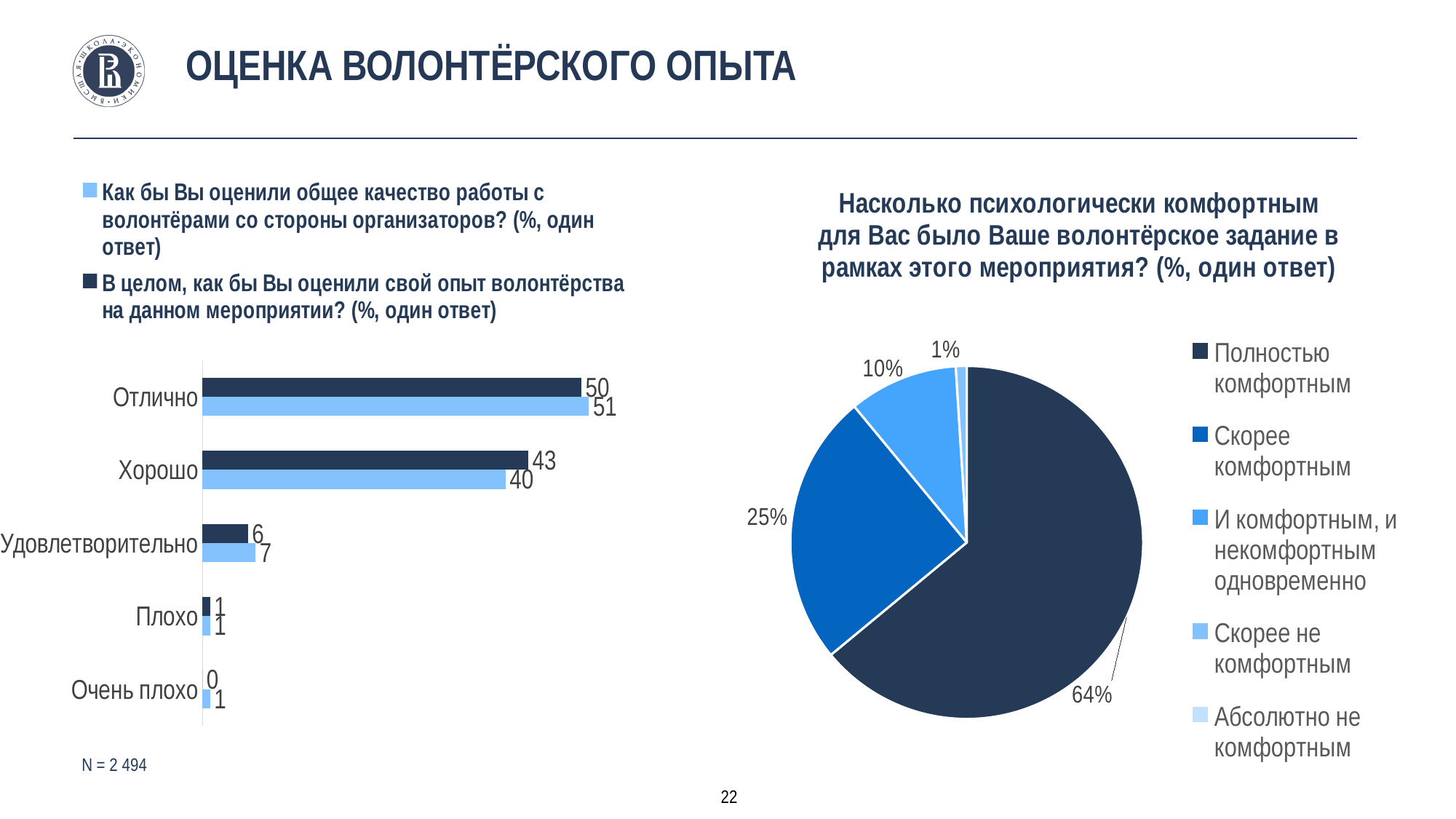
On the left bar chart, what is the value for Отлично in the series 'В целом, как бы Вы оценили свой опыт волонтёрства на данном мероприятии?'? 50 On the left bar chart, which category has the highest value in the series 'В целом, как бы Вы оценили свой опыт волонтёрства на данном мероприятии?'? Отлично On the pie chart 'Насколько психологически комфортным для Вас было Ваше волонтёрское задание в рамках этого мероприятия?', how many entries does the legend list? 5 On the left bar chart, what is the value for Хорошо in the series 'Как бы Вы оценили общее качество работы с волонтёрами со стороны организаторов?'? 40 On the left bar chart, how many series does the legend list? 2 On the pie chart 'Насколько психологически комфортным для Вас было Ваше волонтёрское задание в рамках этого мероприятия?', what share is Полностью комфортным? 64% What kind of chart is the chart on the left of the slide? Bar chart On the pie chart 'Насколько психологически комфортным для Вас было Ваше волонтёрское задание в рамках этого мероприятия?', what share is Скорее комфортным? 25% On the left bar chart, how many categories are shown? 5 On the left bar chart, what is the value for Удовлетворительно in the series 'Как бы Вы оценили общее качество работы с волонтёрами со стороны организаторов?'? 7 On the left bar chart, which category has the lowest value in the series 'В целом, как бы Вы оценили свой опыт волонтёрства на данном мероприятии?'? Очень плохо On the left bar chart, what is the difference between the two series' values for Хорошо? 3